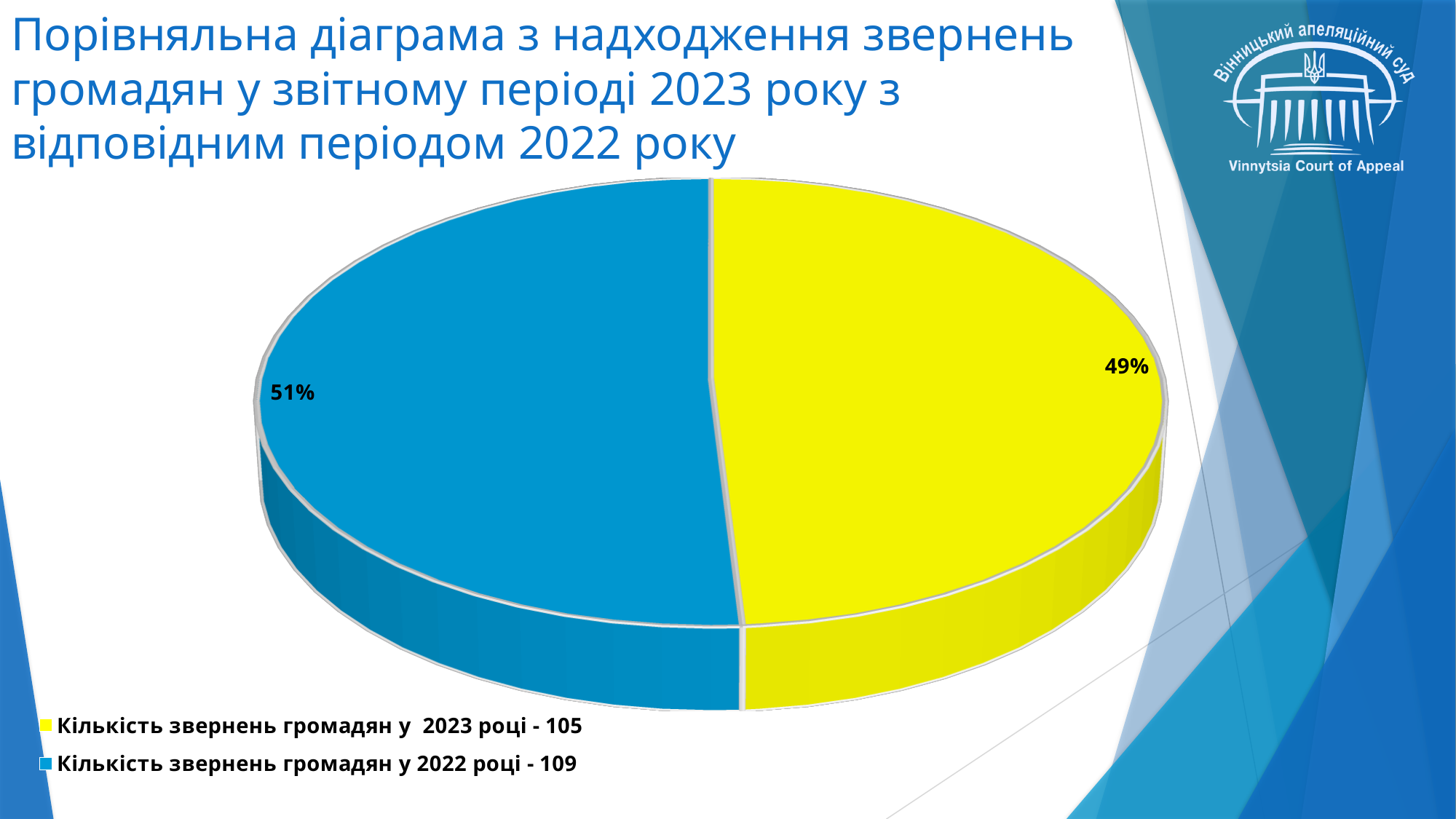
What colour is the slice representing appeals in 2022? blue Which year has the larger slice of the pie, 2022 or 2023? 2022 Which year has the smallest share of the pie? 2023 What is the difference between the number of appeals in 2022 and in 2023? 4 What type of chart is shown on the slide? pie chart According to the legend, how many citizen appeals were received in 2023? 105 What share of the pie does the blue slice (appeals in 2022) represent? 51% What share of the pie does the yellow slice (appeals in 2023) represent? 49% How many slices does the pie chart have? 2 According to the legend, how many citizen appeals were received in 2022? 109 What colour is the slice representing appeals in 2023? yellow How many entries does the legend list? 2